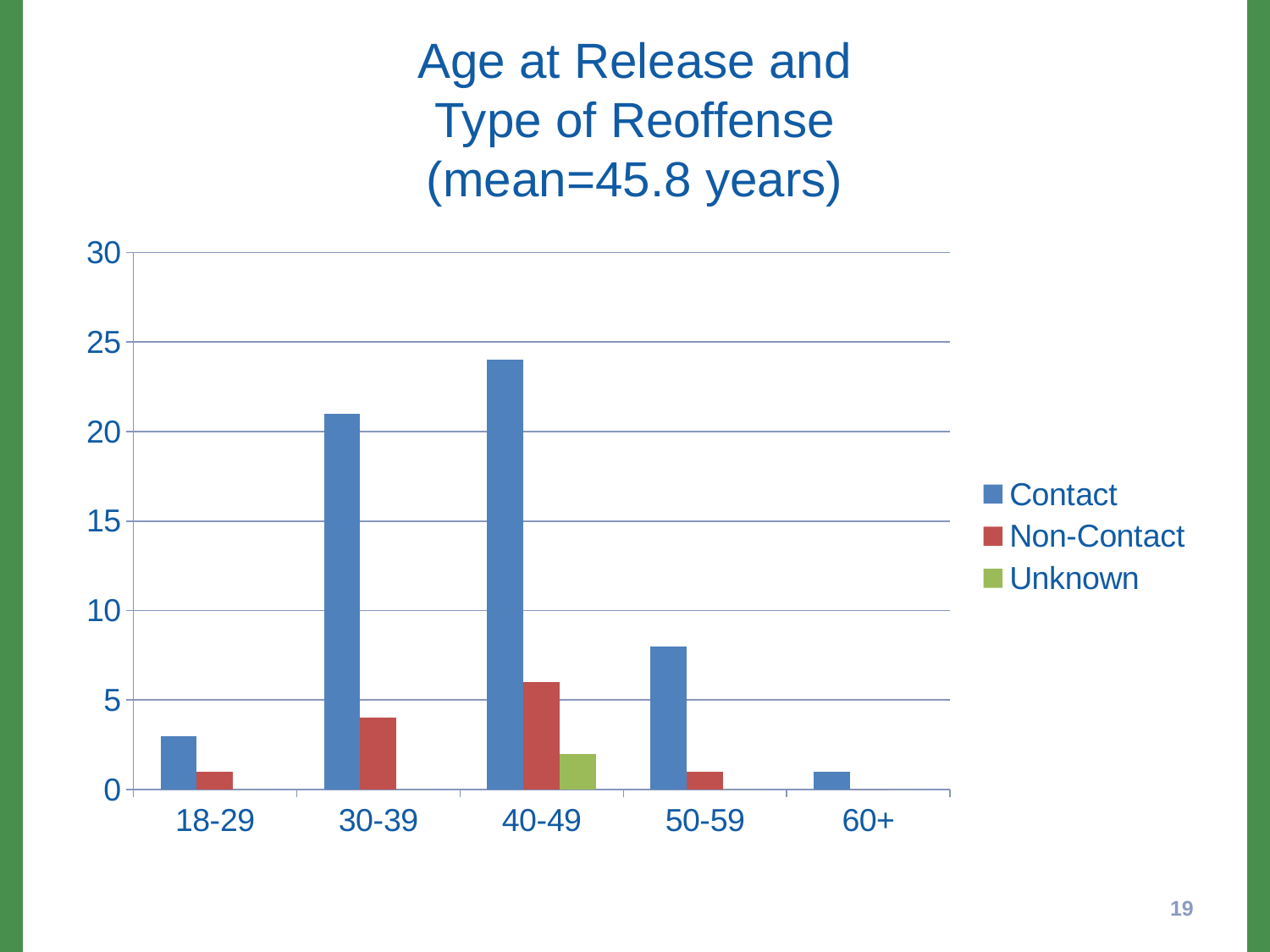
Is the Non-Contact value for 40-49 greater or less than 5? greater How many series does the legend list? 3 How many age groups are shown on the x axis? 5 Is the Contact value for 50-59 greater or less than 10? less Which age group has the highest Non-Contact value? 40-49 Which is larger, the Contact value for 40-49 or the Contact value for 30-39? 40-49 Which age group has the lowest Contact value? 60+ What mean age is given in the chart title? 45.8 years Which age group is the only one with a visible Unknown bar? 40-49 Which age group has the highest Contact value? 40-49 Is the Contact value for 30-39 greater or less than 20? greater What kind of chart is shown on the slide? bar chart